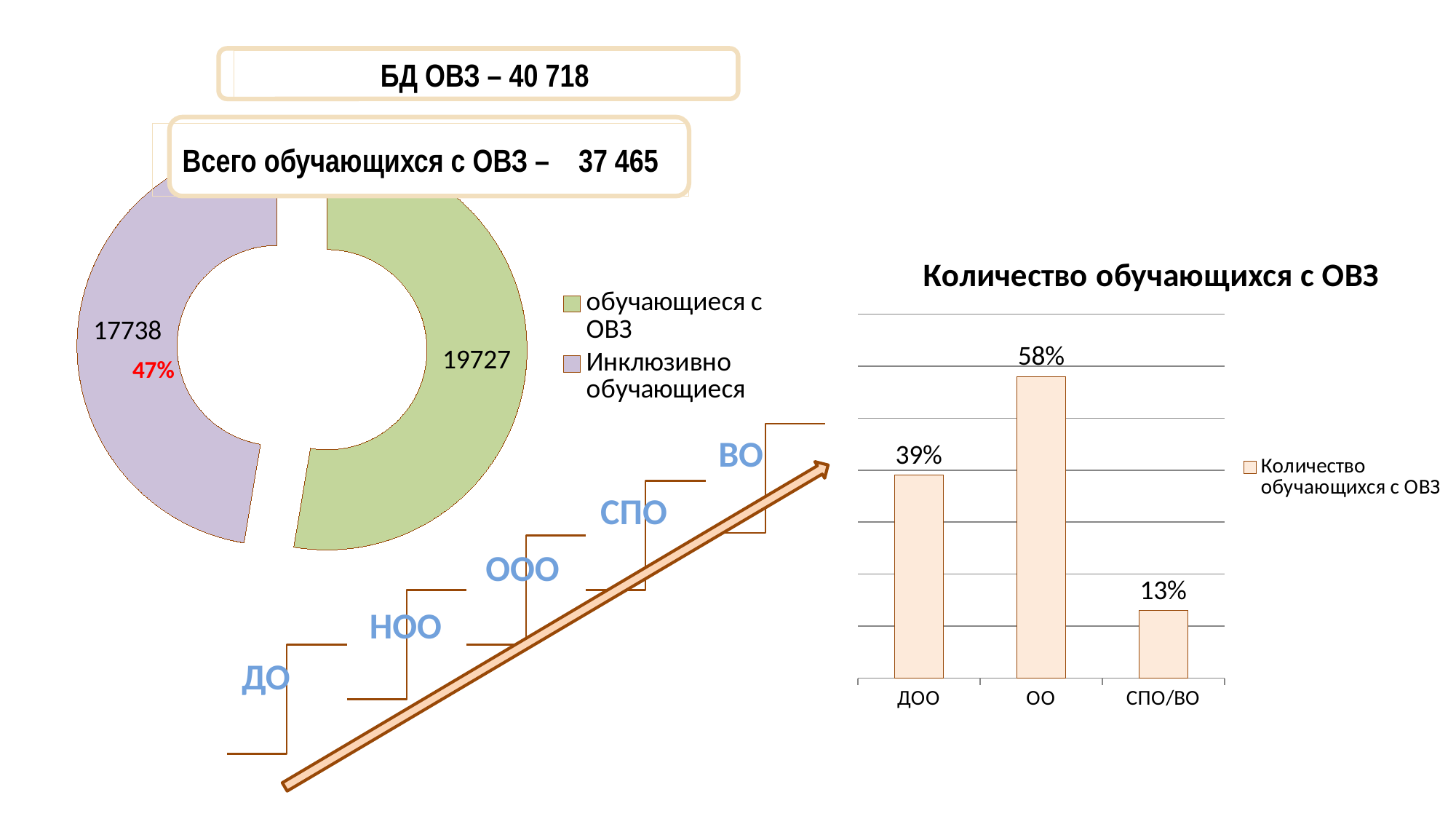
What kind of chart is the chart on the right titled 'Количество обучающихся с ОВЗ'? Bar chart In the doughnut chart on the left, which is larger: 'обучающиеся с ОВЗ' or 'Инклюзивно обучающиеся'? обучающиеся с ОВЗ In the doughnut chart on the left, what is the value for 'Инклюзивно обучающиеся'? 17738 In the bar chart titled 'Количество обучающихся с ОВЗ', which category has the highest value? ОО In the bar chart titled 'Количество обучающихся с ОВЗ', what is the value for ДОО? 39% In the bar chart titled 'Количество обучающихся с ОВЗ', what is the value for СПО/ВО? 13% In the bar chart titled 'Количество обучающихся с ОВЗ', what is the difference between the values for ОО and ДОО? 19% In the doughnut chart on the left, what percentage is printed on the 'Инклюзивно обучающиеся' segment? 47% In the doughnut chart on the left, what is the value for 'обучающиеся с ОВЗ'? 19727 In the bar chart titled 'Количество обучающихся с ОВЗ', how many categories are shown on the x axis? 3 In the bar chart titled 'Количество обучающихся с ОВЗ', which category has the lowest value? СПО/ВО In the bar chart titled 'Количество обучающихся с ОВЗ', what is the value for ОО? 58%